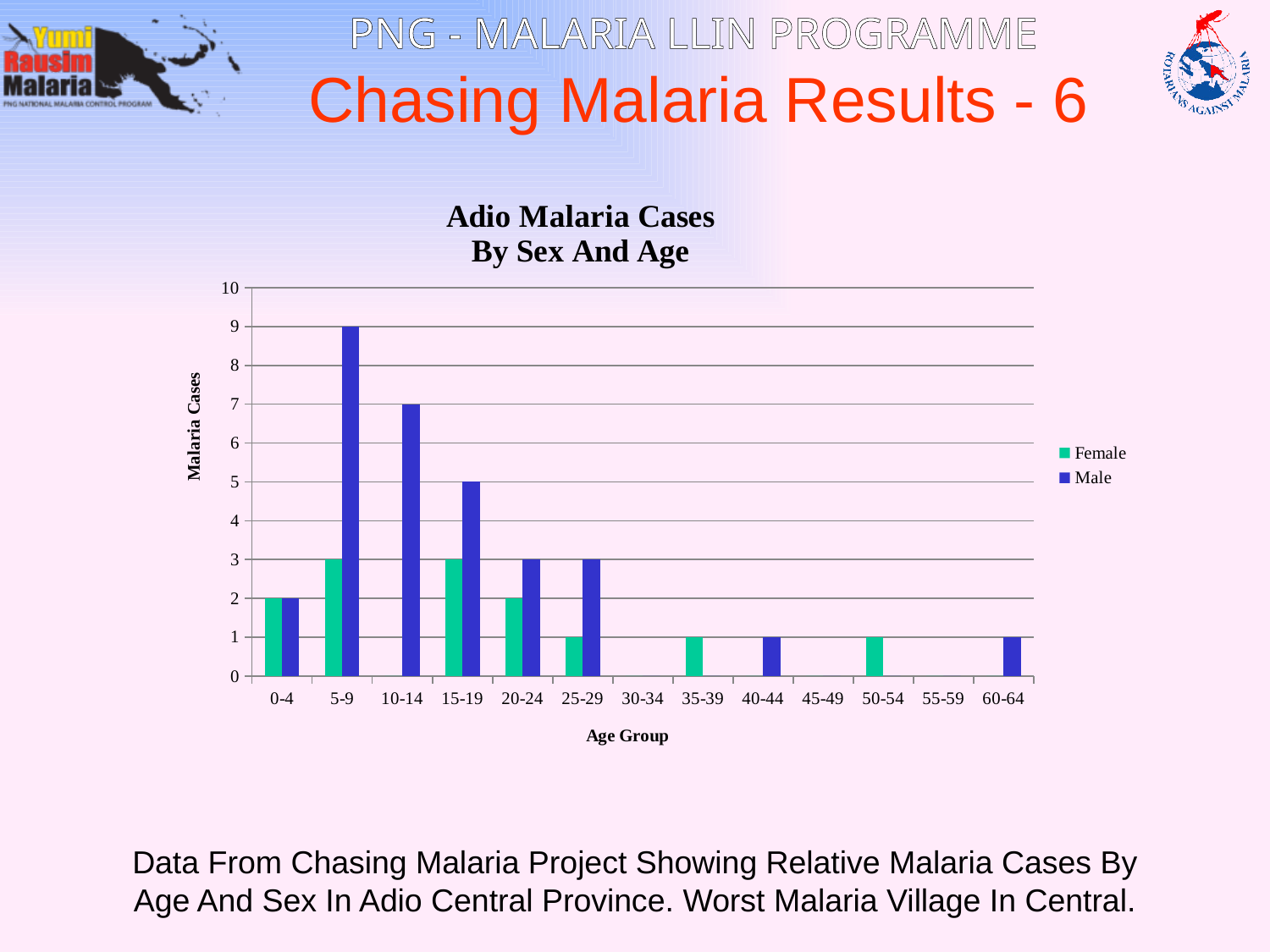
How many series does the legend list? 2 What is the number of Male malaria cases in the 10-14 age group? 7 Which age group has the highest number of Male malaria cases? 5-9 What is the difference between Male and Female malaria cases in the 5-9 age group? 6 Is the number of Male malaria cases in the 15-19 age group greater or less than 4? greater What is the title of the chart? Adio Malaria Cases By Sex And Age What kind of chart is shown on the slide? bar chart Which is larger in the 20-24 age group, Male or Female malaria cases? Male What is the label of the y axis? Malaria Cases What is the number of Female malaria cases in the 15-19 age group? 3 What is the number of Male malaria cases in the 5-9 age group? 9 How many age groups are shown on the x axis? 13